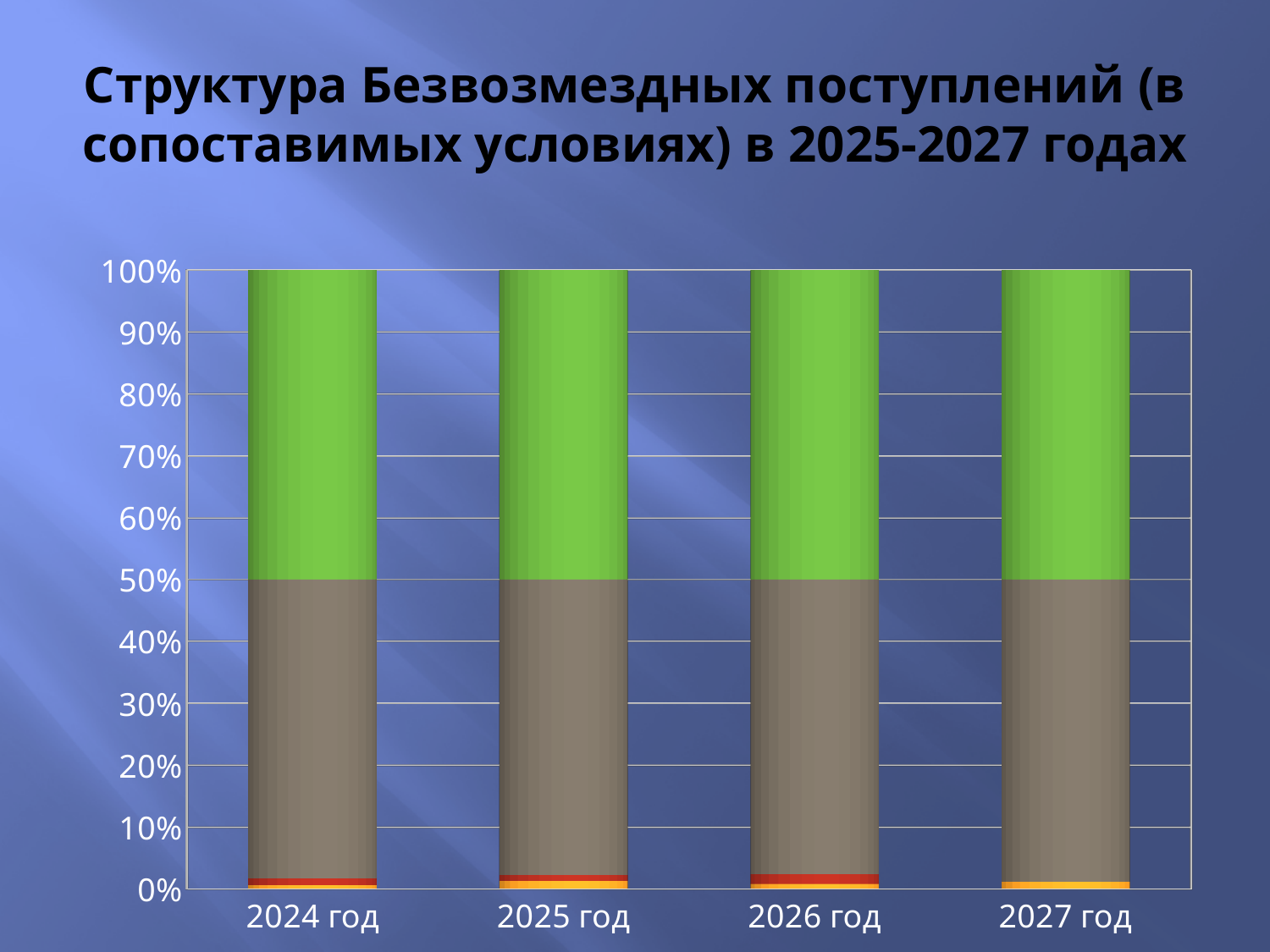
Is the top of the green segment for 2025 год greater or less than 90%? greater Which category is the first one on the x axis of the chart? 2024 год What is the title of the chart on the slide? Структура Безвозмездных поступлений (в сопоставимых условиях) в 2025-2027 годах How many categories (years) are shown on the x axis of the chart? 4 Is the red segment at the bottom of the bar for 2026 год greater or less than 10%? less What is the total height of the stacked bar for 2027 год? 100% What kind of chart is shown on the slide? stacked bar chart What is the total height of the stacked bar for 2024 год? 100% What is the highest value shown on the vertical axis of the chart? 100% Do the total heights of the stacked bars rise, fall, or stay the same from 2024 год to 2027 год? stay the same Is the orange segment at the bottom of the bar for 2027 год greater or less than 10%? less